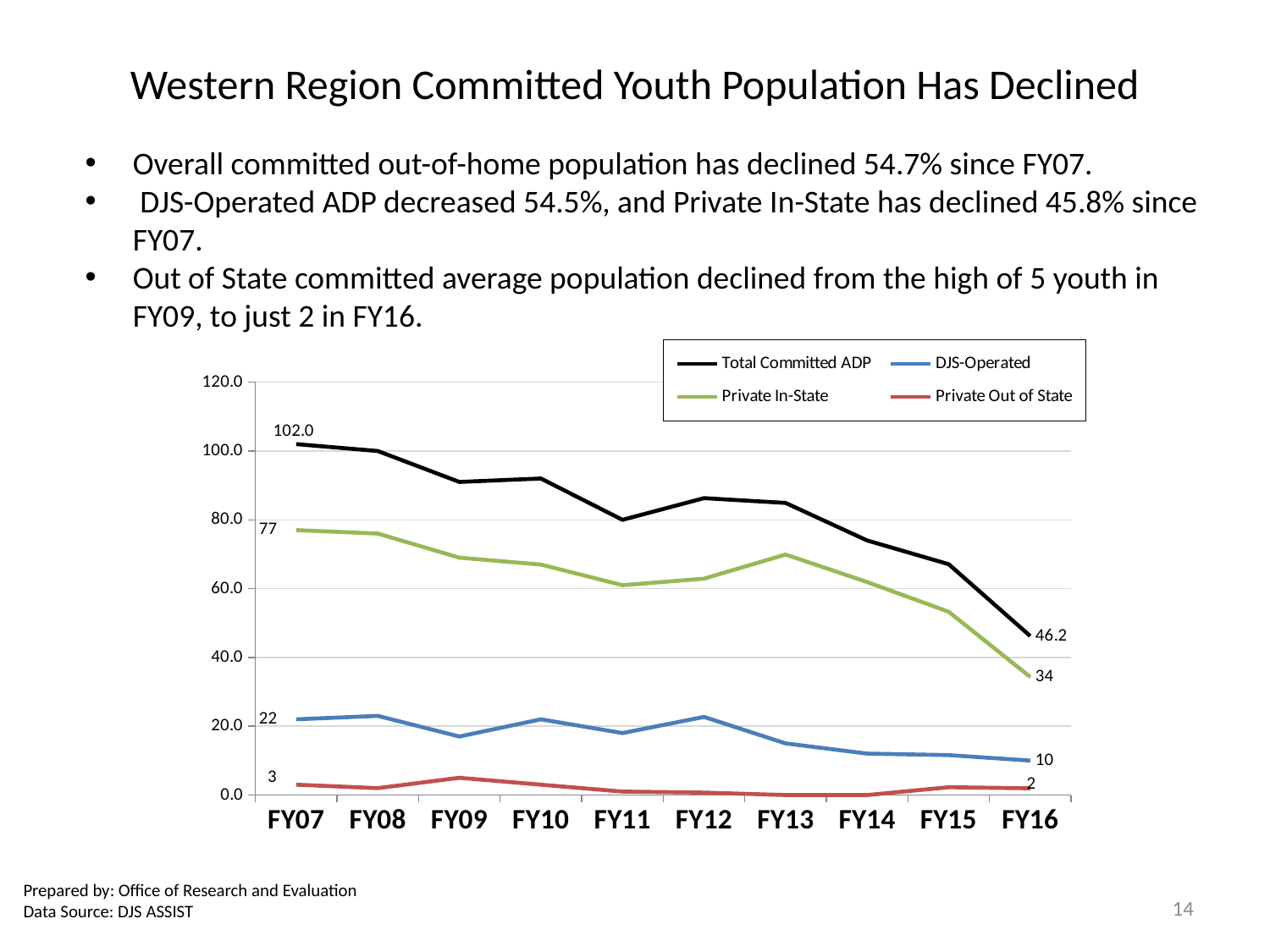
How many fiscal years are plotted along the x axis? 10 Does the Total Committed ADP line generally rise or fall from FY07 to FY16? fall By how much did the Total Committed ADP fall from FY07 to FY16? 55.8 What is the DJS-Operated value for FY16? 10 What is the difference between the Private In-State values for FY07 and FY16? 43 What type of chart is shown on the slide? line chart How many series does the legend list? 4 What is the Total Committed ADP value for FY16? 46.2 Is the Total Committed ADP value for FY11 greater or less than 100.0? less What is the Total Committed ADP value for FY07? 102.0 What is the Private Out of State value for FY07? 3 What is the Private In-State value for FY07? 77